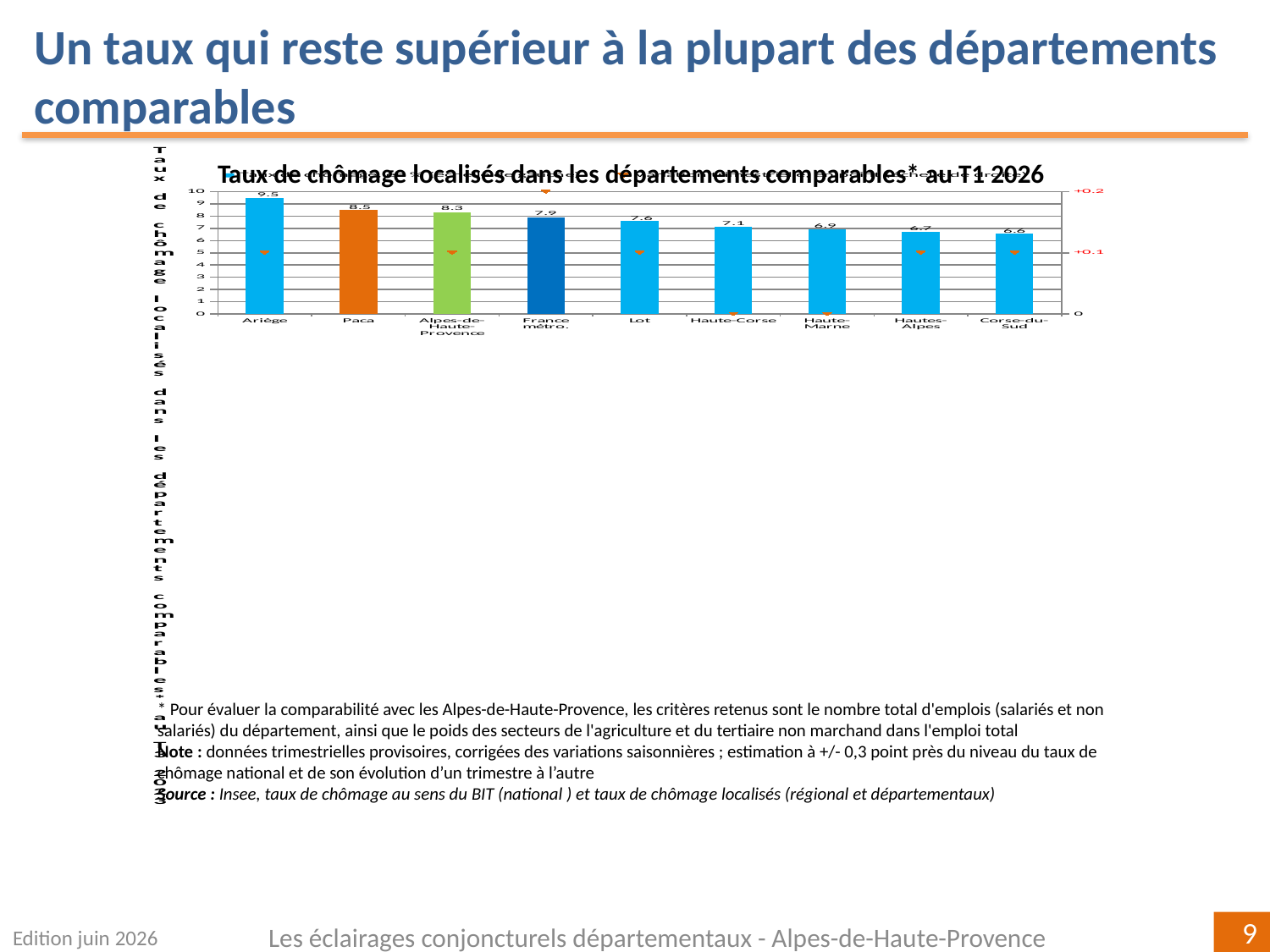
What kind of chart is used to show the unemployment rates? Bar chart Which category has the highest bar? Ariège Which is larger, the value for Lot or the value for Haute-Corse? Lot What is the difference between the values for Alpes-de-Haute-Provence and France métro.? 0.4 Do the bar values rise or fall from left to right along the x axis? Fall What is the value shown for Corse-du-Sud? 6.6 How many categories are shown on the x axis of the bar chart? 9 Which category has the lowest bar? Corse-du-Sud What is the value shown for France métro.? 7.9 What is the value shown for Alpes-de-Haute-Provence? 8.3 What is the difference between the values for Ariège and Paca? 1.0 What is the unemployment rate shown for Ariège? 9.5